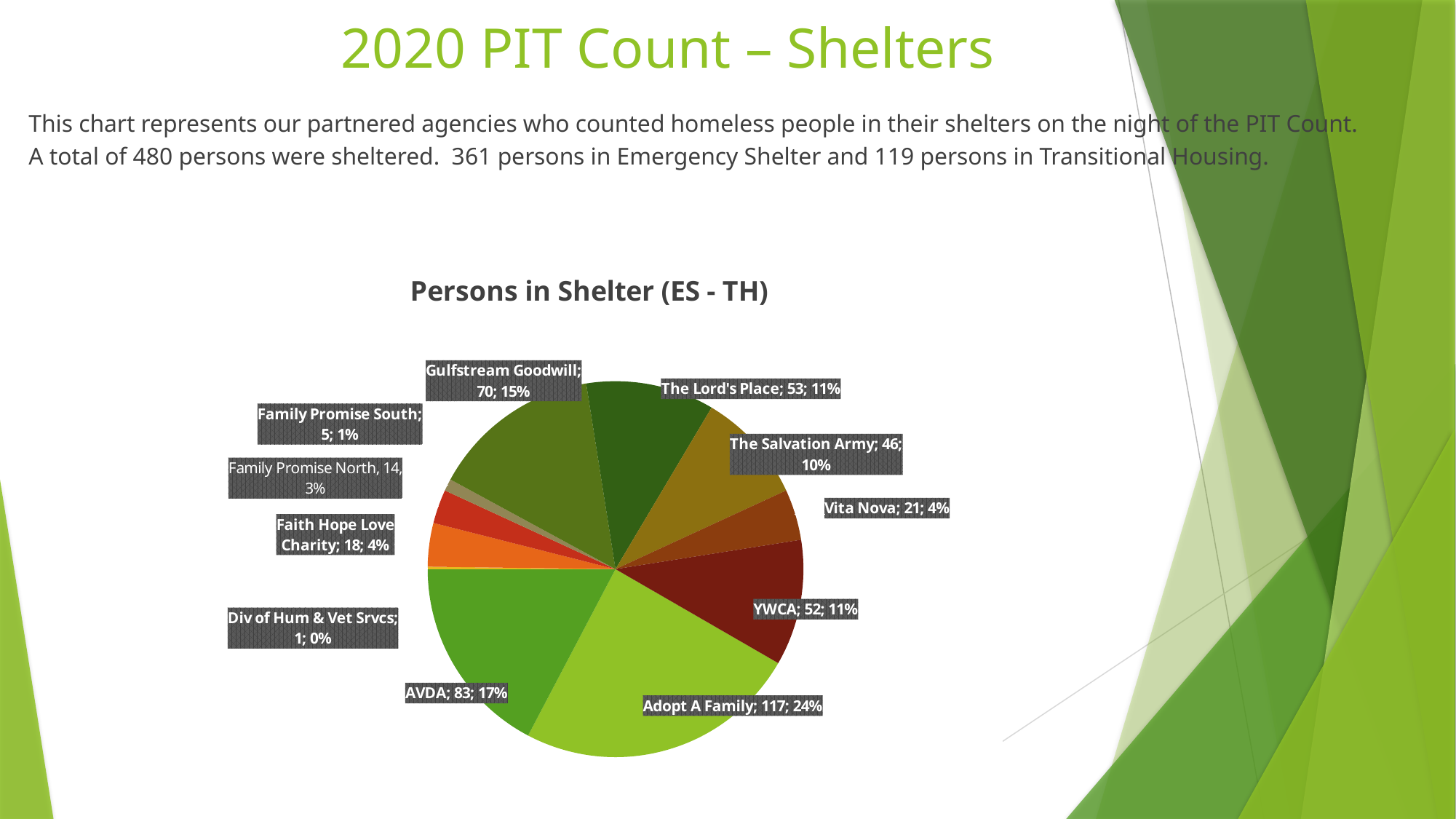
What is the difference in persons between Adopt A Family and AVDA? 34 What is the title of the chart? Persons in Shelter (ES - TH) Which agency has the smallest slice of the pie? Div of Hum & Vet Srvcs How many persons are shown for Family Promise North? 14 How many persons are shown for Gulfstream Goodwill? 70 Which agency has the largest slice of the pie? Adopt A Family How many persons are shown for Adopt A Family? 117 What percentage share of the pie does The Salvation Army have? 10% What kind of chart is shown on the slide? Pie chart How many agencies (slices) are shown in the pie chart? 11 What percentage share of the pie does AVDA have? 17% Which has more persons, The Lord's Place or The Salvation Army? The Lord's Place